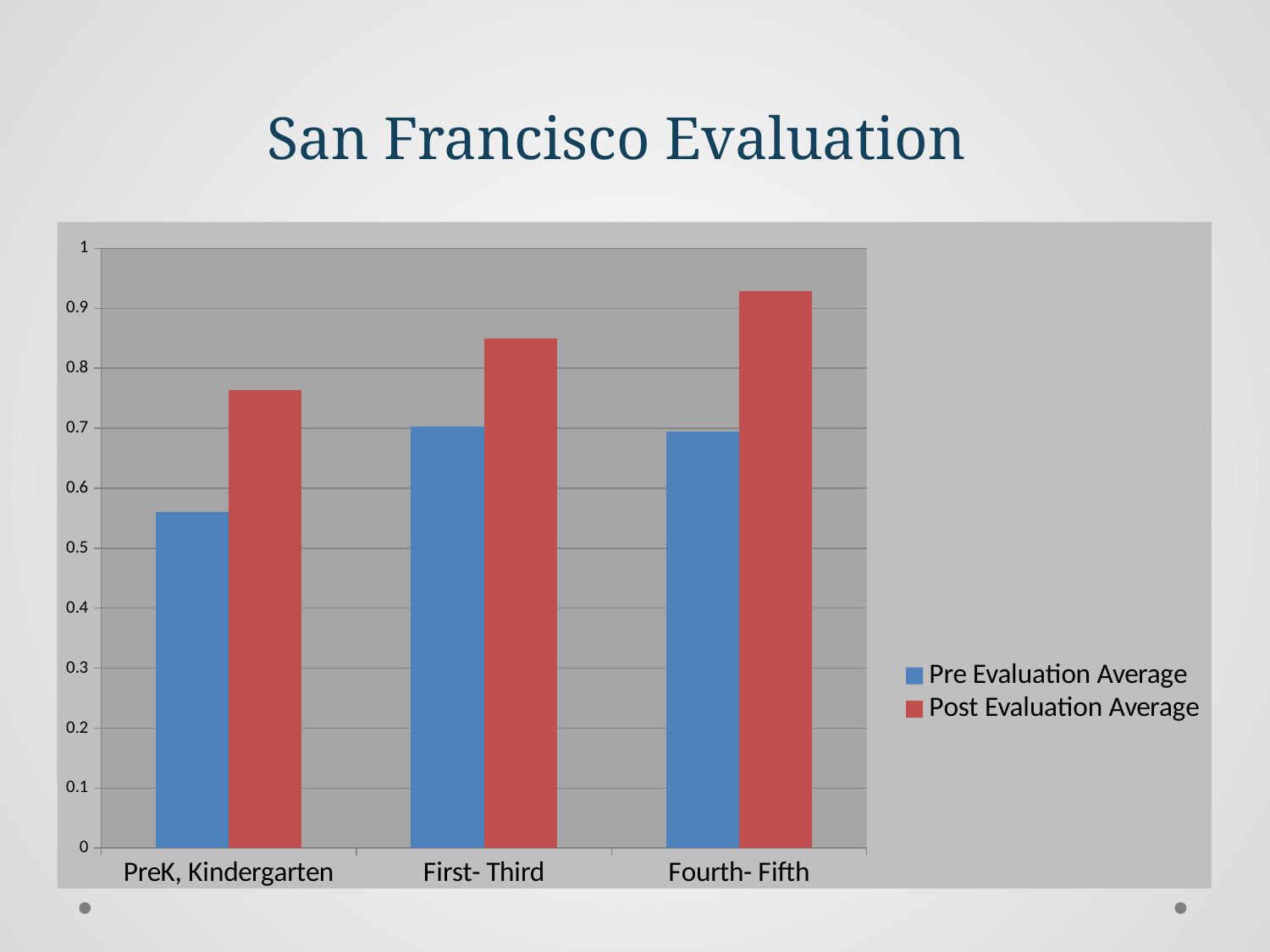
Do the Post Evaluation Average values rise or fall from PreK, Kindergarten to Fourth- Fifth? rise What kind of chart is shown on the slide? bar chart Which category has the highest Post Evaluation Average? Fourth- Fifth What is the title of the slide? San Francisco Evaluation How many grade-level categories are shown on the x axis? 3 How many series does the legend list? 2 Which category has the lowest Pre Evaluation Average? PreK, Kindergarten Which category has the lowest Post Evaluation Average? PreK, Kindergarten Is the Post Evaluation Average for Fourth- Fifth greater or less than 0.9? greater Is the Post Evaluation Average for First- Third greater or less than 0.8? greater Is the Pre Evaluation Average for PreK, Kindergarten greater or less than 0.5? greater For First- Third, which is larger: the Pre Evaluation Average or the Post Evaluation Average? Post Evaluation Average